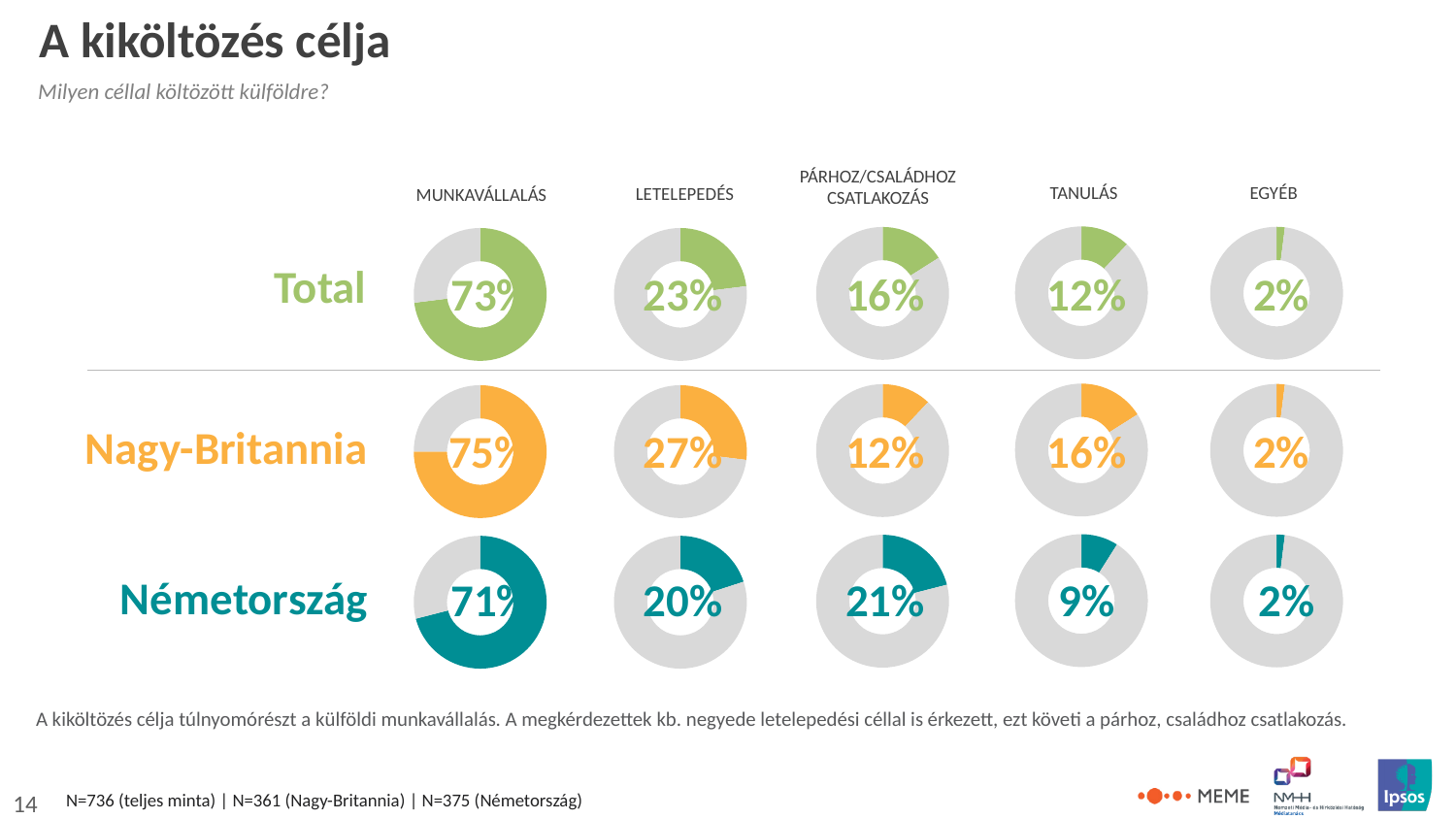
In the Nagy-Britannia row, what is the value shown for Letelepedés? 27% What is the difference between the Letelepedés values for Total and Németország? 3% In the Németország row, what is the value shown for Párhoz/családhoz csatlakozás? 21% In the Nagy-Britannia row, what is the value shown for Tanulás? 16% In the Németország row, which category has the lowest value? Egyéb Which is larger: the Tanulás value for Nagy-Britannia or for Németország? Nagy-Britannia What is the difference between the Munkavállalás values for Nagy-Britannia and Németország? 4% In the Total row, which category has the highest value? Munkavállalás How many donut charts are shown in each row? 5 What kind of chart is used to show the values on this slide? Donut (pie) chart What colour are the donut segments in the Németország row? Teal In the Total row, what is the value shown for Munkavállalás? 73%